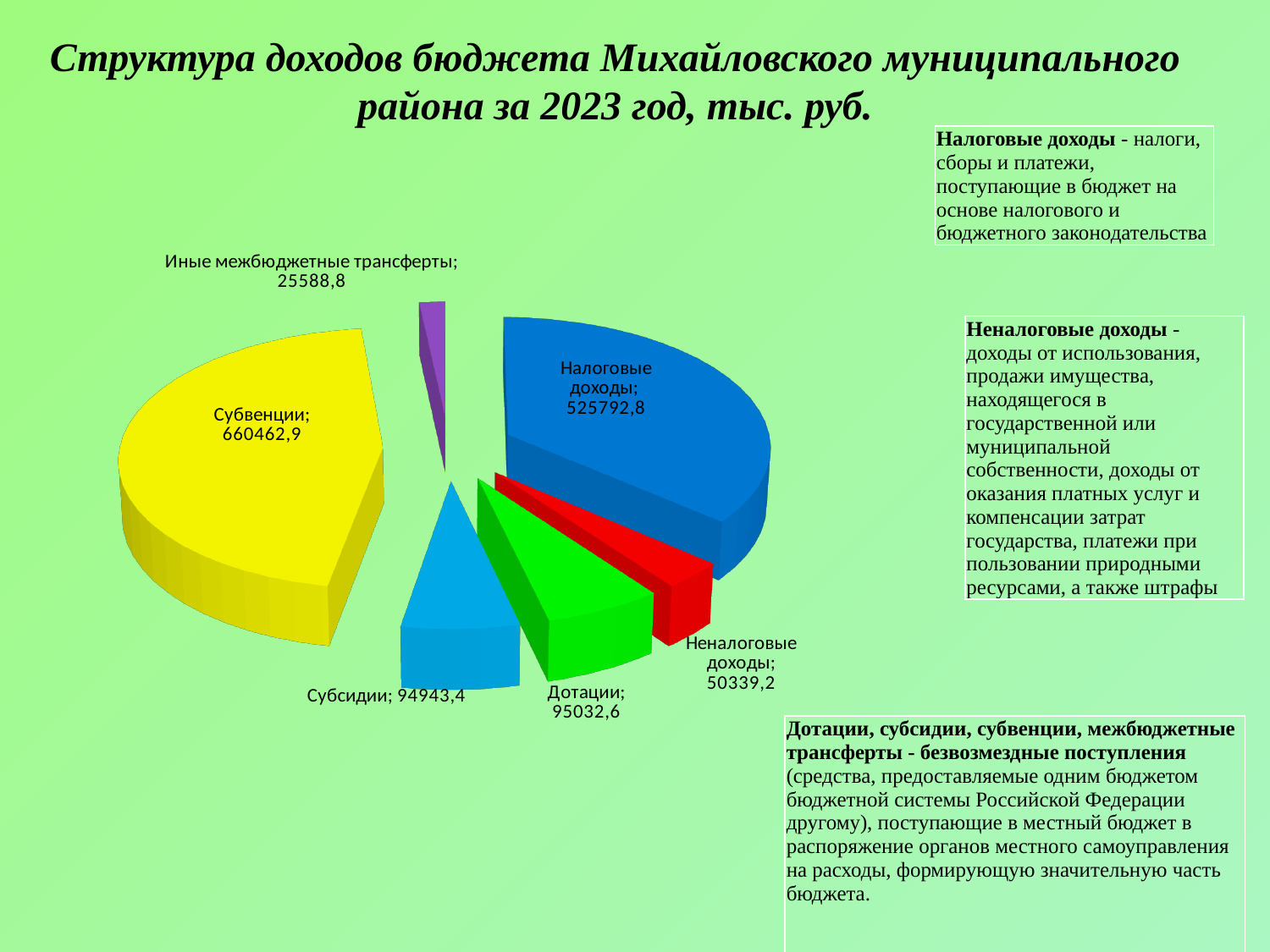
Which category has the largest value? Субвенции What is the value for Налоговые доходы? 525792,8 What is the value for Неналоговые доходы? 50339,2 How many categories (slices) does the pie chart have? 6 What is the value for Иные межбюджетные трансферты? 25588,8 What colour is the slice for Субвенции? Yellow Which category has the smallest value? Иные межбюджетные трансферты Which is larger, Субсидии or Неналоговые доходы? Субсидии What is the difference between Субвенции and Налоговые доходы? 134670,1 What type of chart is shown on the slide? Pie chart What is the value for Субвенции? 660462,9 What is the difference between Налоговые доходы and Неналоговые доходы? 475453,6